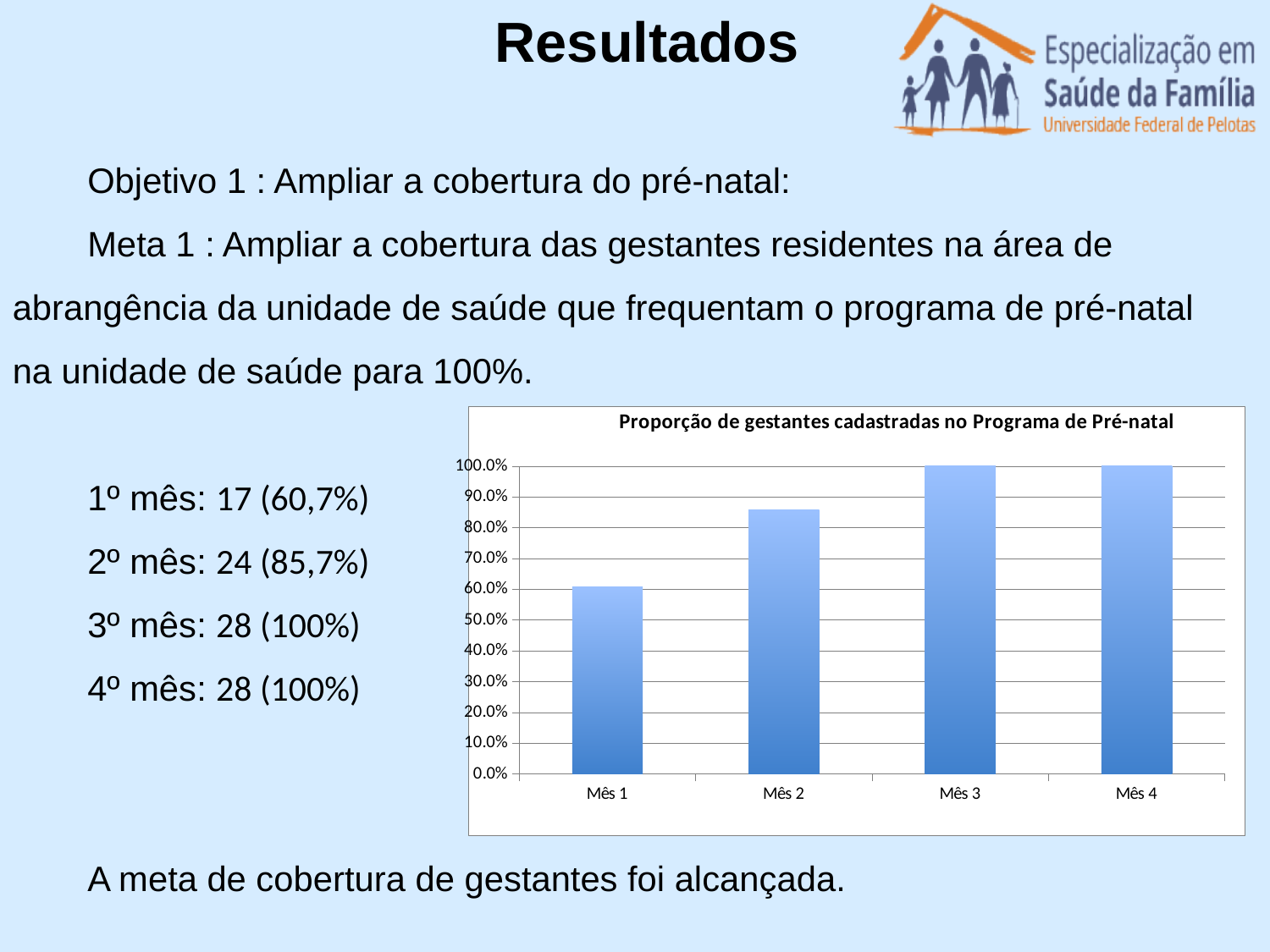
What kind of chart is shown on the slide? bar chart How many months (categories) are plotted on the x axis of the chart? 4 Do the values rise or fall from Mês 1 to Mês 4? rise What is the title of the chart? Proporção de gestantes cadastradas no Programa de Pré-natal Is the value for Mês 1 greater or less than 50.0%? greater Is the value for Mês 1 greater or less than 70.0%? less What is the value for Mês 4 in the chart? 100.0% Which is larger, the value for Mês 1 or the value for Mês 2? Mês 2 Is the value for Mês 2 greater or less than 80.0%? greater What is the difference between the values for Mês 3 and Mês 4? 0.0% What is the value for Mês 3 in the chart? 100.0% Which month has the lowest value in the chart? Mês 1